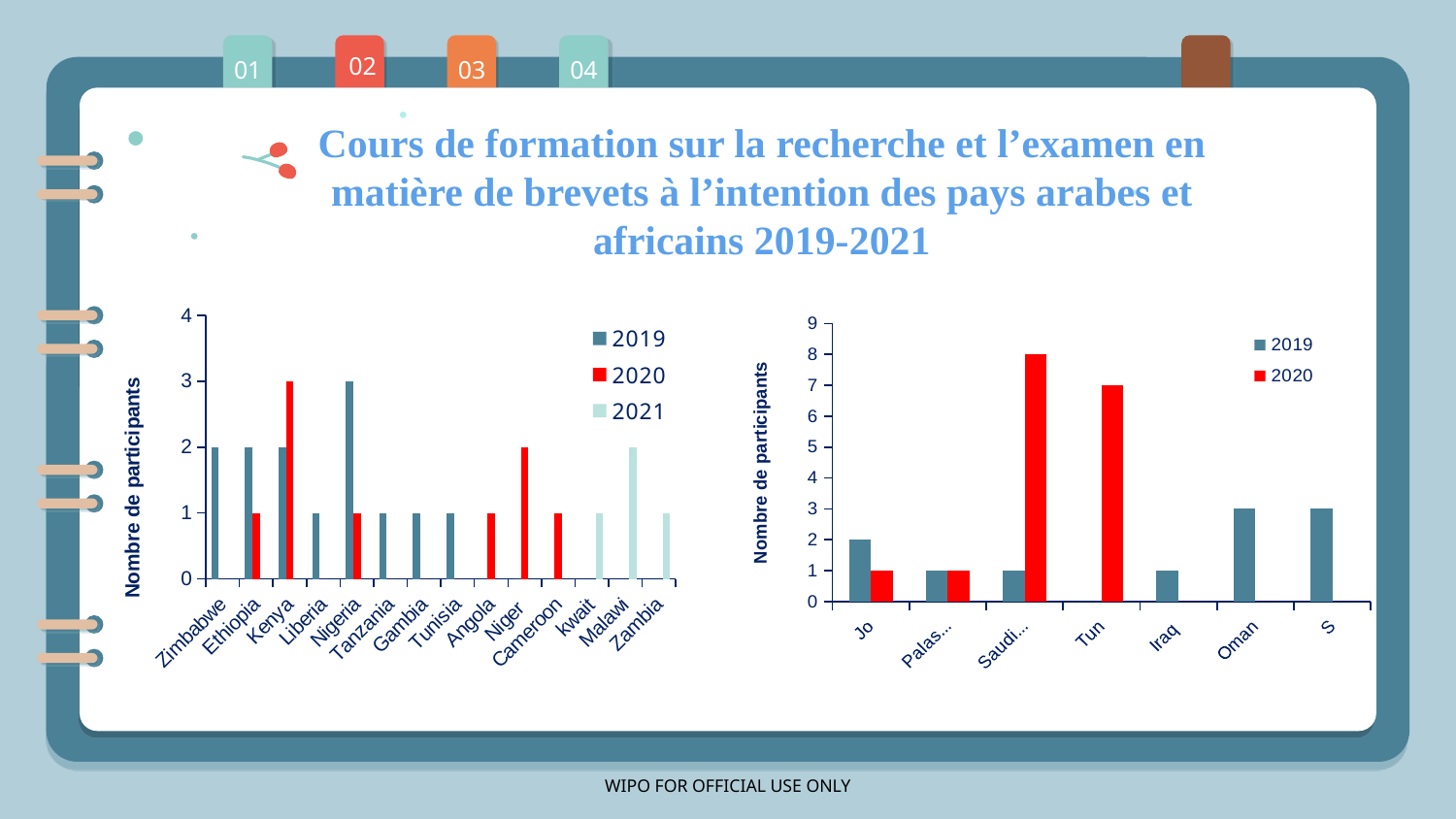
On the right chart, how many series does the legend list? 2 On the right chart, how many countries are shown on the x axis? 7 On the right chart, what is the 2020 value for Tun? 7 On the left chart, how many countries are shown on the x axis? 14 On the left chart, how many series does the legend list? 3 On the left chart, what kind of chart is shown? bar chart On the left chart, what is the 2020 value for Kenya? 3 On the left chart, which country has the highest 2021 value? Malawi On the right chart, what is the difference between the 2019 value for Oman and the 2019 value for Iraq? 2 On the left chart, what is the 2019 value for Nigeria? 3 On the left chart, which is larger: the 2020 value for Niger or the 2020 value for Cameroon? Niger On the right chart, which country has the highest 2020 value? Saudi...